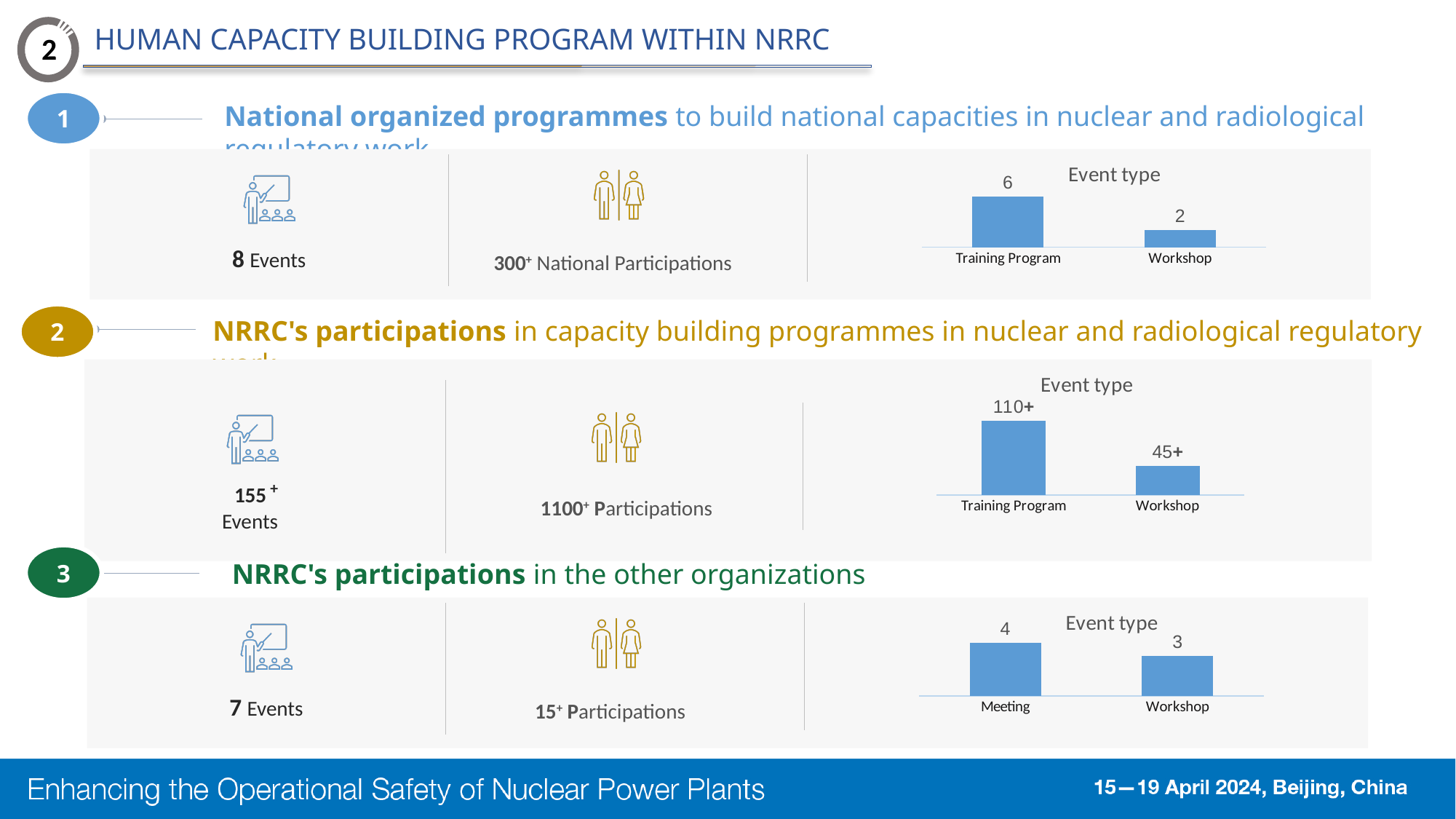
In the bottom 'Event type' chart (section 3), what is the value for Meeting? 4 In the top 'Event type' chart (section 1), what is the difference between Training Program and Workshop? 4 In the middle 'Event type' chart (section 2), what is the value for Workshop? 45+ In the bottom 'Event type' chart (section 3), which category has the lowest value? Workshop In the bottom 'Event type' chart (section 3), what is the difference between Meeting and Workshop? 1 What kind of chart is the middle 'Event type' chart (section 2)? Bar chart In the top 'Event type' chart (section 1), what is the value for Workshop? 2 How many categories are shown in the top 'Event type' chart (section 1)? 2 In the middle 'Event type' chart (section 2), what is the value for Training Program? 110+ In the bottom 'Event type' chart (section 3), what is the value for Workshop? 3 In the top 'Event type' chart (section 1), what is the value for Training Program? 6 In the middle 'Event type' chart (section 2), which category has the highest value? Training Program